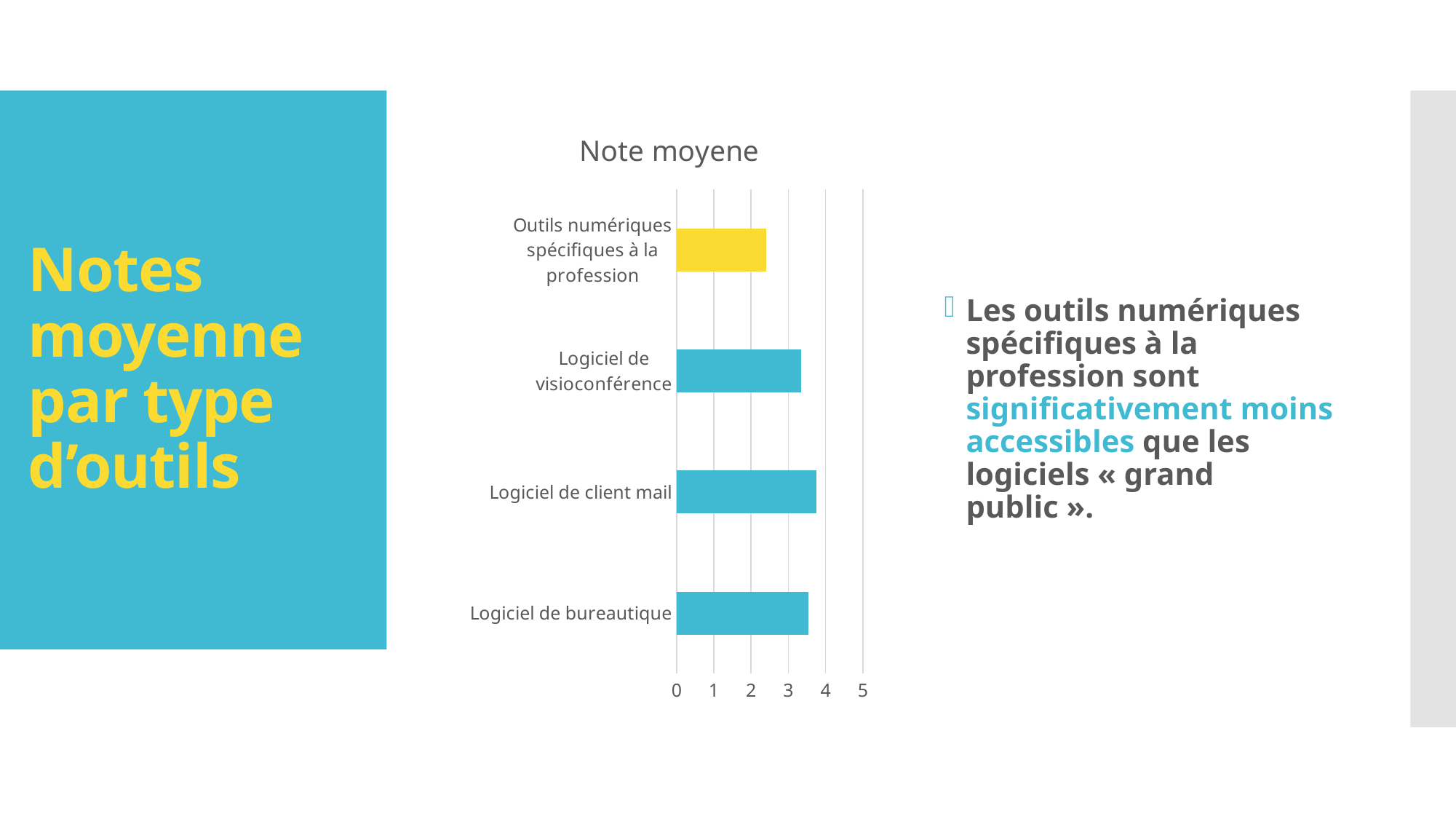
What is the title of the chart? Note moyene Is the value for Logiciel de visioconférence greater or less than 3? greater Which category has the lowest value in the chart? Outils numériques spécifiques à la profession Which is larger, the value for Logiciel de bureautique or the value for Outils numériques spécifiques à la profession? Logiciel de bureautique Is the value for Outils numériques spécifiques à la profession greater or less than 3? less What kind of chart is shown on the slide? bar chart Which is larger, the value for Logiciel de client mail or the value for Logiciel de visioconférence? Logiciel de client mail Is the value for Outils numériques spécifiques à la profession greater or less than 2? greater How many categories are plotted in the chart? 4 Which category's bar is coloured yellow instead of blue? Outils numériques spécifiques à la profession